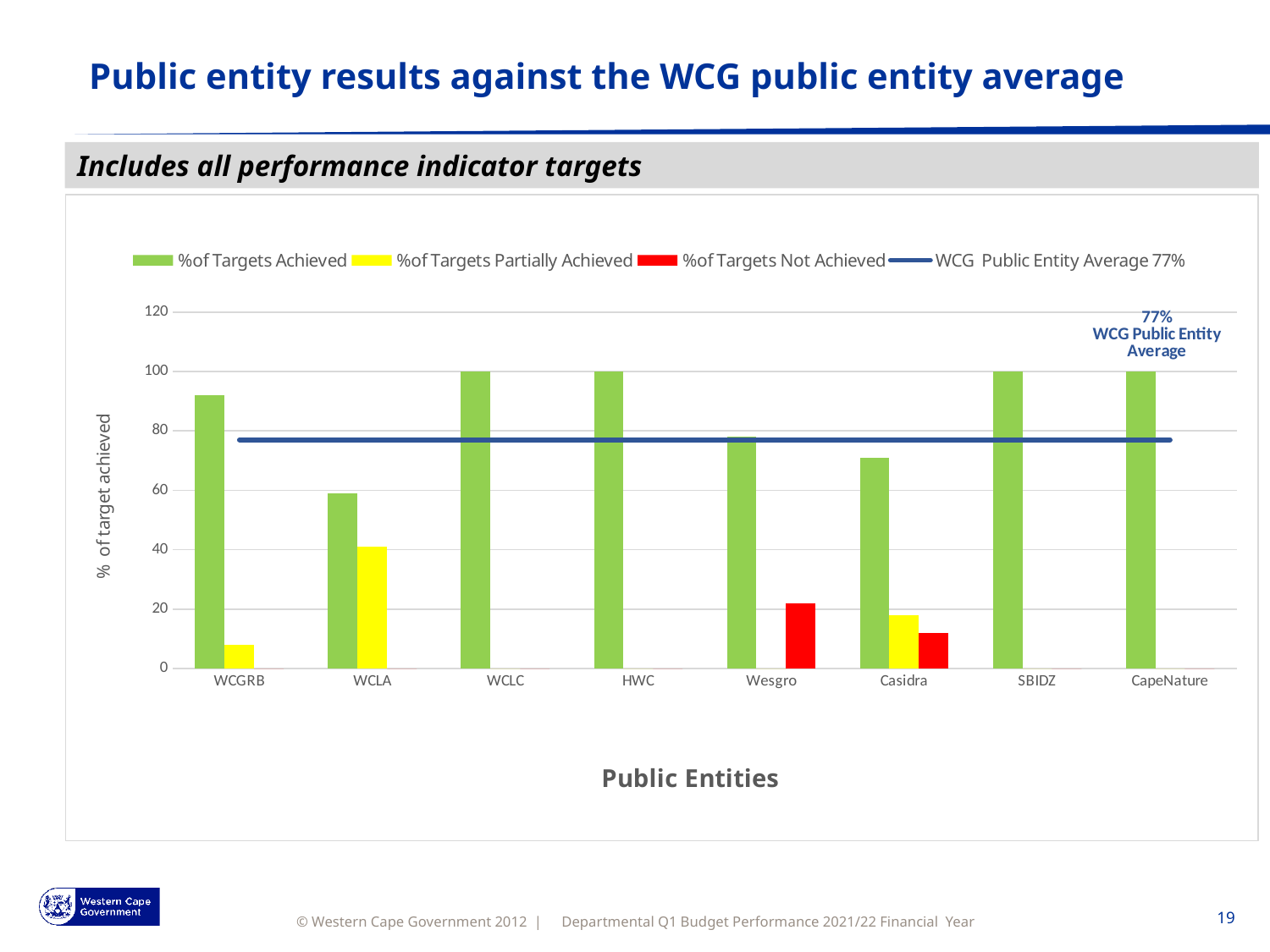
What is the WCG Public Entity Average shown on the chart? 77% Which has a higher % of Targets Achieved, WCGRB or WCLA? WCGRB Which public entity has the highest % of Targets Not Achieved? Wesgro Which public entity has the highest % of Targets Partially Achieved? WCLA Is the % of Targets Not Achieved value for Casidra greater or less than 20? less Which public entity has the lowest % of Targets Achieved? WCLA How many entries does the chart's legend list? 4 How many public entities are shown on the x axis of the chart? 8 What kind of chart is shown on the slide? combination bar and line chart What is the % of Targets Achieved value for WCLC? 100 Is the % of Targets Achieved value for WCGRB greater or less than 80? greater What is the % of Targets Achieved value for SBIDZ? 100